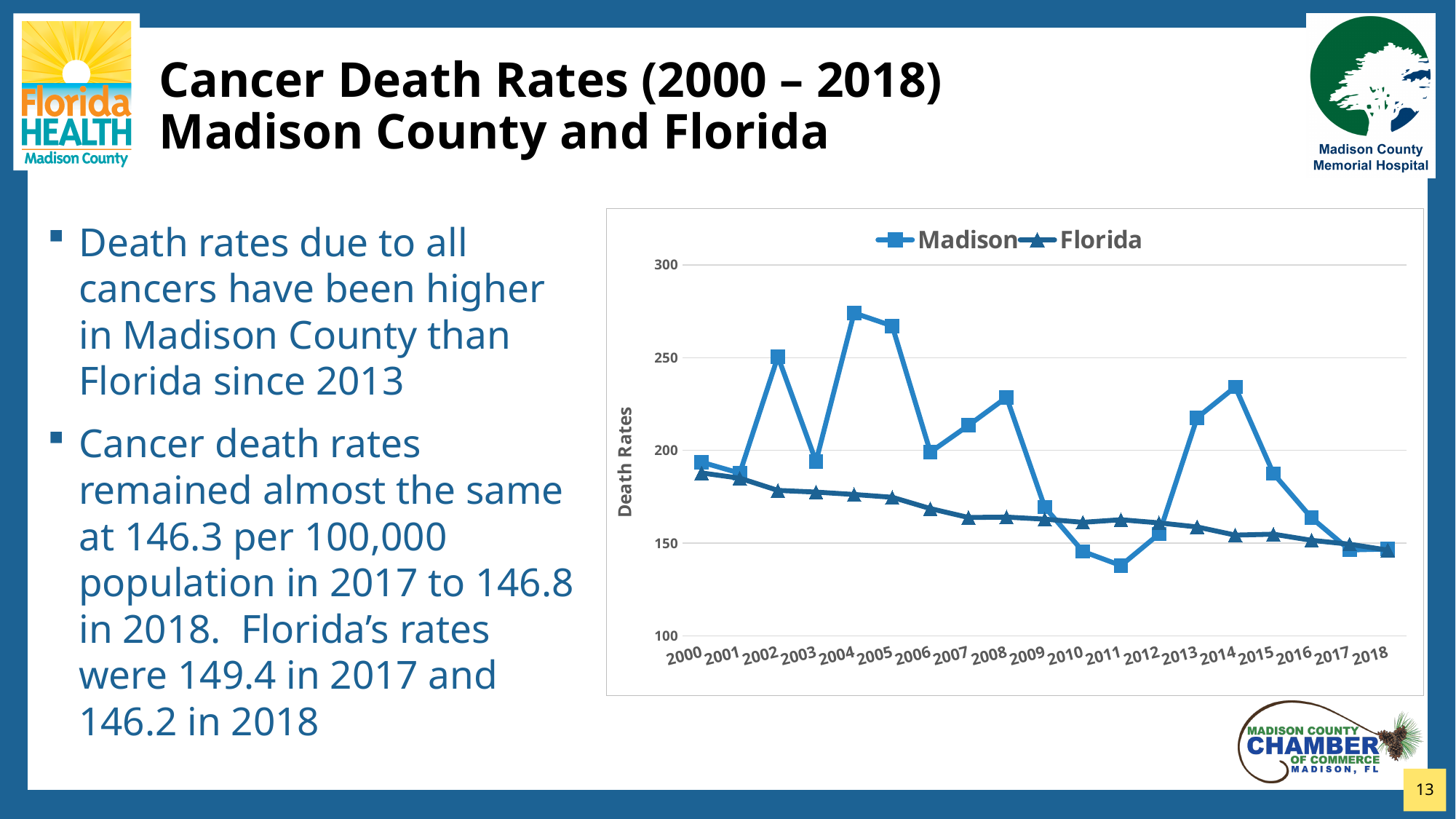
How many series does the chart legend list? 2 Is the Madison value for 2011 greater or less than 150? less Is the Madison value for 2004 greater or less than 250? greater Is the Florida value for 2000 greater or less than 200? less In which year does the Madison series reach its highest value? 2004 How many years are plotted along the x axis of the chart? 19 In 2010, which series has the higher value, Madison or Florida? Florida What is the Florida cancer death rate for 2017, as stated on the slide? 149.4 Does the Florida series generally rise or fall from 2000 to 2018? Fall What kind of chart is shown on the slide? Line chart In which year does the Madison series reach its lowest value? 2011